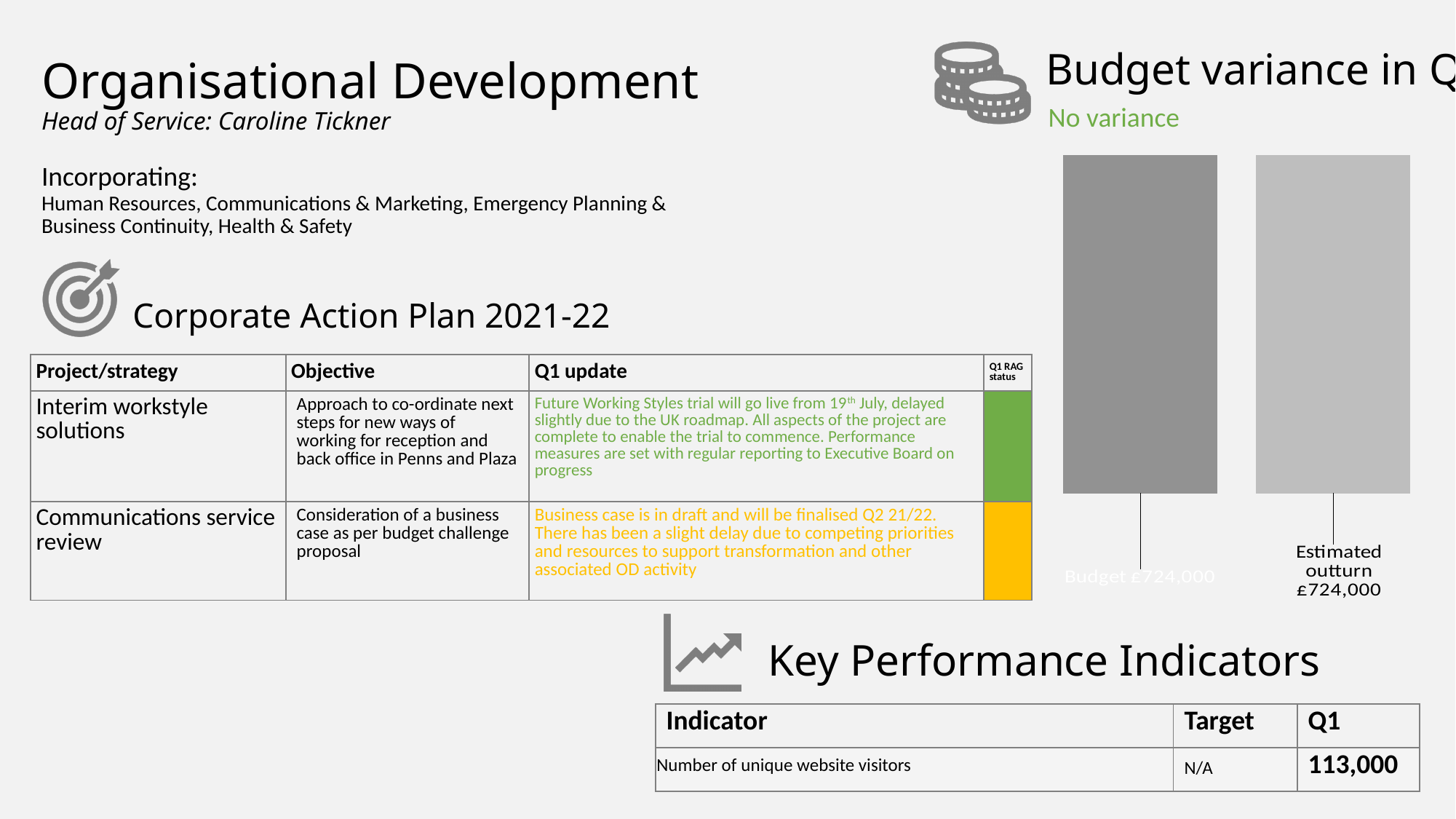
What is the difference between the Budget and Estimated outturn values in the budget variance chart? £0 What is the value of the Estimated outturn bar in the budget variance chart? £724,000 How many bars does the budget variance chart show? 2 What kind of chart is shown under the budget variance heading? bar chart What text appears in green beneath the budget variance heading? No variance What is the value of the Budget bar in the budget variance chart? £724,000 Which bar is on the left in the budget variance chart? Budget